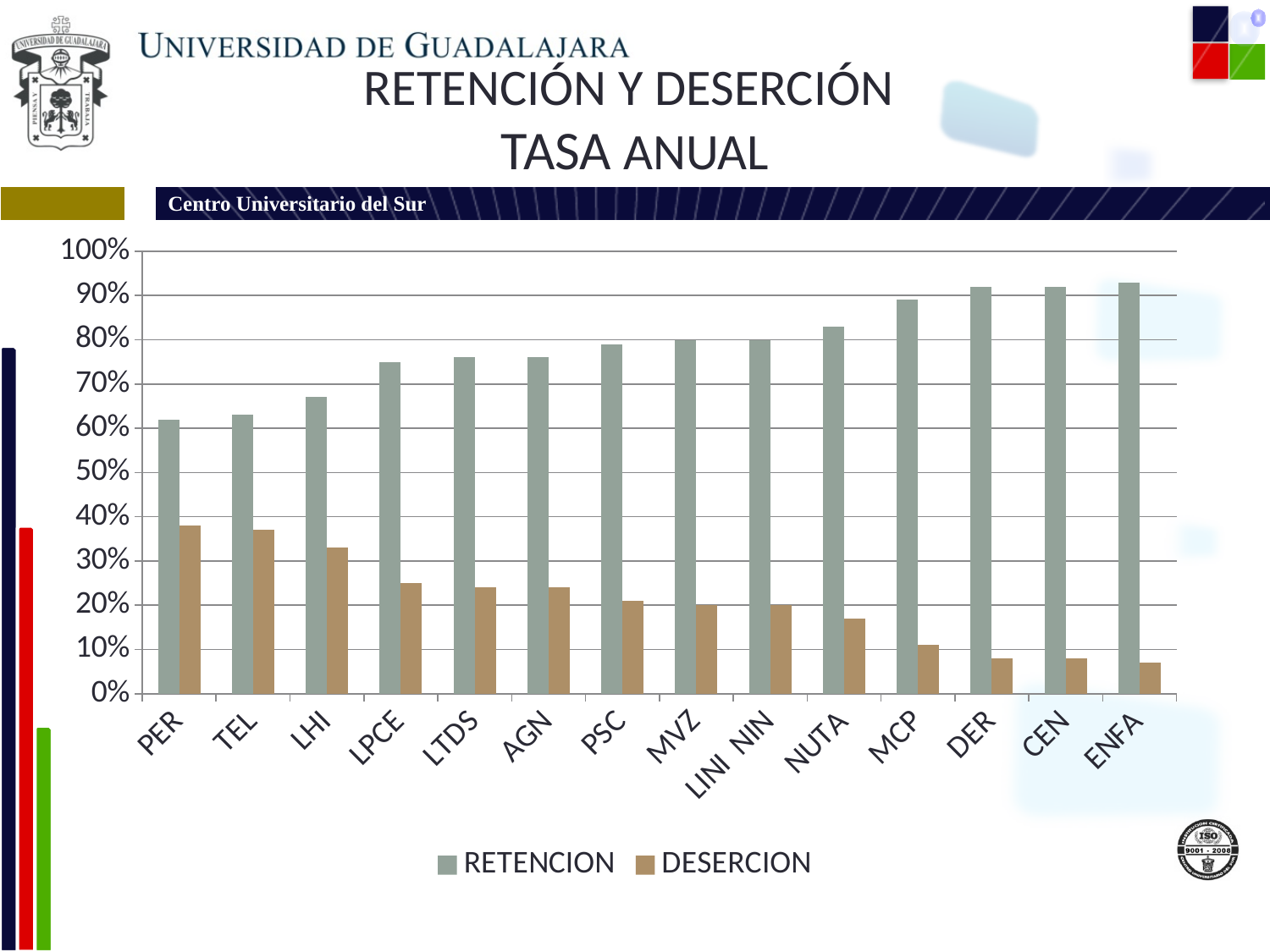
What kind of chart is shown on the slide? bar chart How many categories are shown on the x axis? 14 How many series does the legend list? 2 Which has a higher RETENCION value, PER or ENFA? ENFA Is the RETENCION value for ENFA greater or less than 90%? greater Is the RETENCION value for PER greater or less than 50%? greater Which series is shown in the brown bars? DESERCION Is the RETENCION value for MVZ greater or less than 70%? greater Do the RETENCION values generally rise or fall from left to right along the x axis? rise Which has a higher DESERCION value, PER or MCP? PER